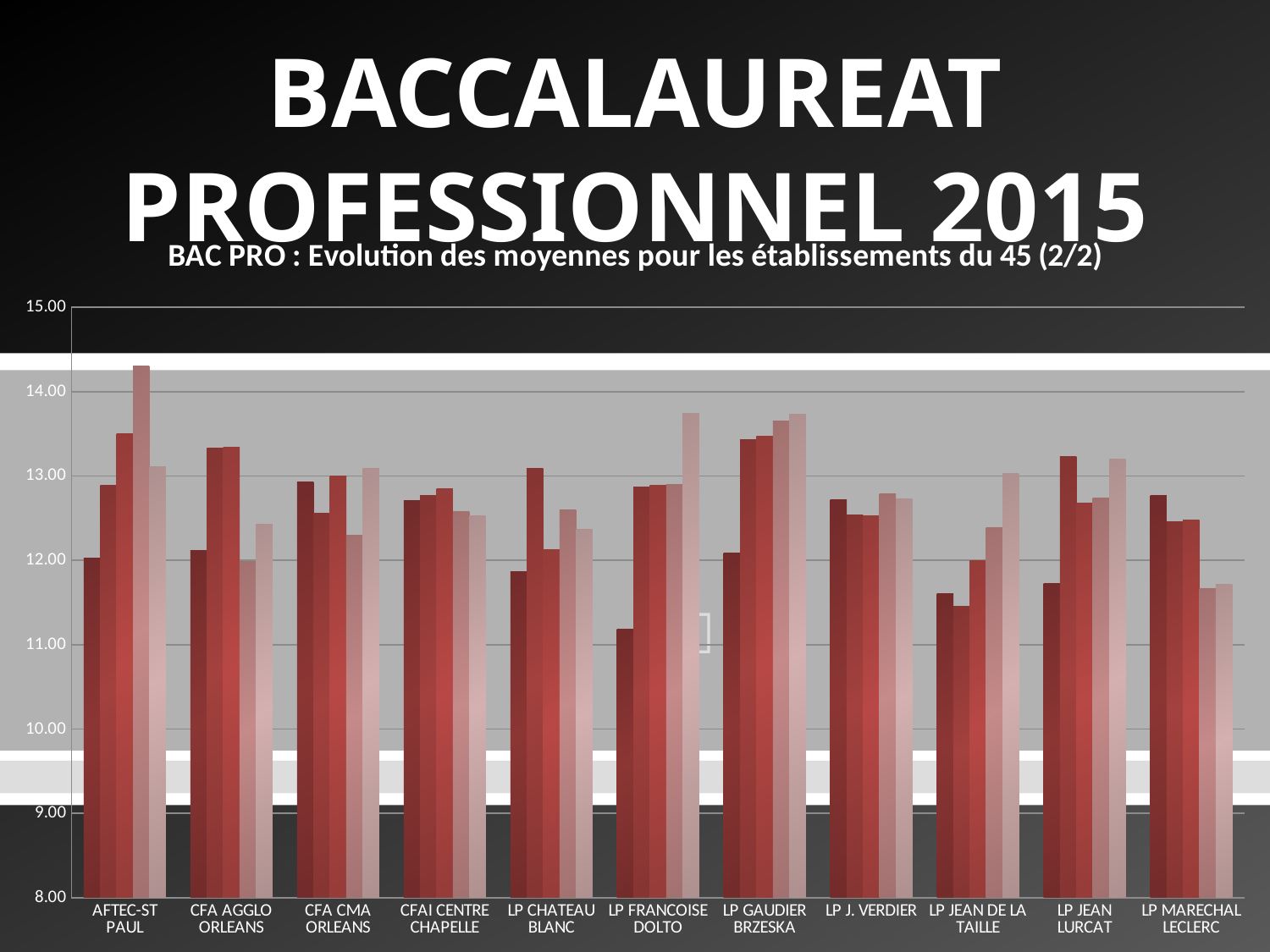
Is the tallest bar for LP GAUDIER BRZESKA greater or less than 13.00? greater Which establishment has the single tallest bar on the chart? AFTEC-ST PAUL Is the lowest bar for LP FRANCOISE DOLTO greater or less than 12.00? less Which is taller: the tallest bar for AFTEC-ST PAUL or the tallest bar for LP GAUDIER BRZESKA? AFTEC-ST PAUL What is the highest value shown on the vertical axis? 15.00 Is the tallest bar for LP JEAN LURCAT greater or less than 13.00? greater How many establishments (categories) are shown along the x axis? 11 What is the title of the chart? BAC PRO : Evolution des moyennes pour les établissements du 45 (2/2) What kind of chart is shown on the slide? bar chart Which establishment has the single lowest bar on the chart? LP FRANCOISE DOLTO